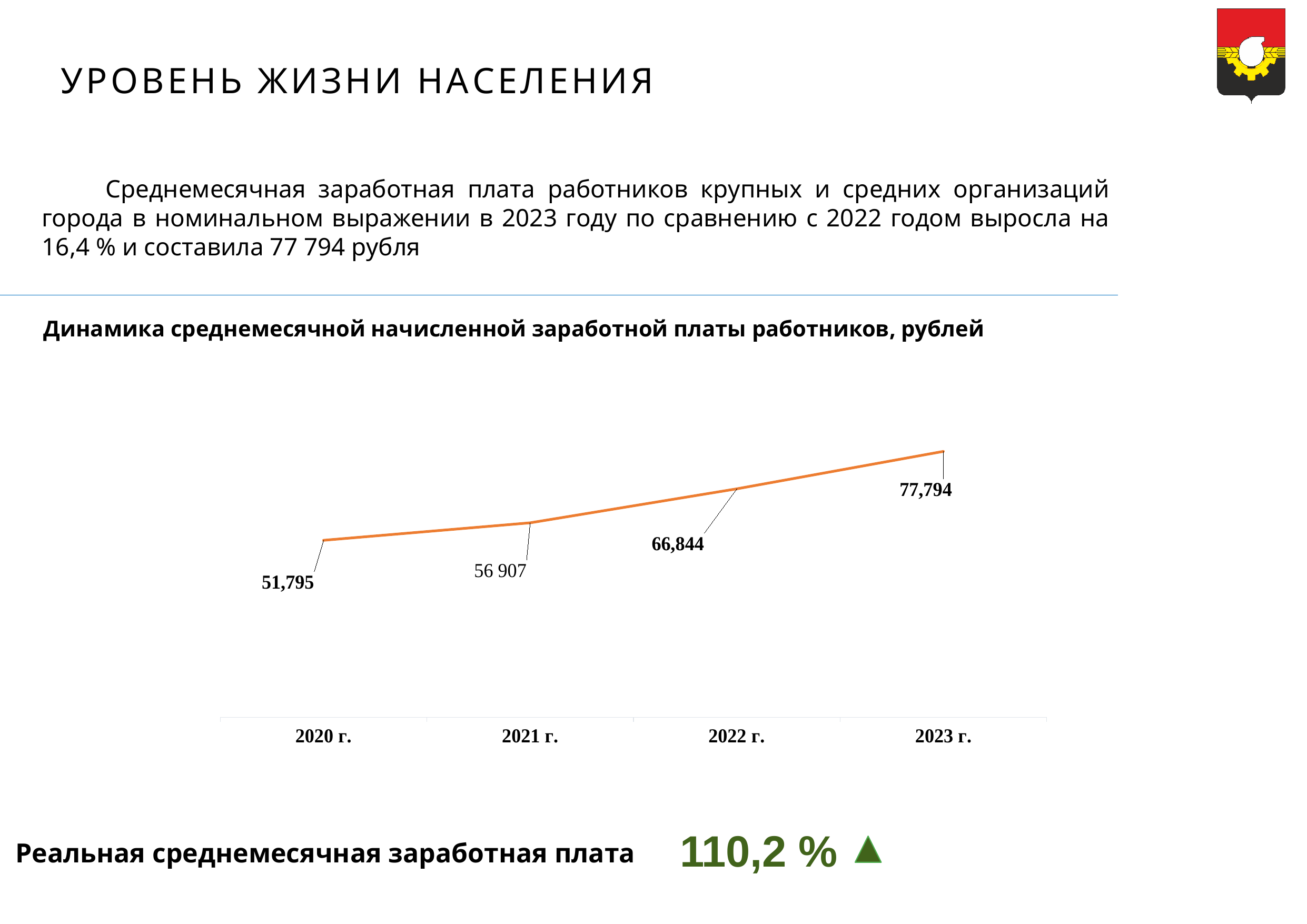
What is the value for 2020 г. on the chart? 51,795 How many years are plotted on the chart? 4 What kind of chart is shown on the slide? line chart What is the value for 2021 г. on the chart? 56 907 What is the value for 2022 г. on the chart? 66,844 What is the difference between the values for 2023 г. and 2022 г.? 10,950 Which year has the lowest value on the chart? 2020 г. What is the value for 2023 г. on the chart? 77,794 Which year has the highest value on the chart? 2023 г. Which is larger, the value for 2021 г. or the value for 2022 г.? 2022 г. Do the values rise or fall from 2020 г. to 2023 г.? rise What is the difference between the values for 2023 г. and 2020 г.? 25,999